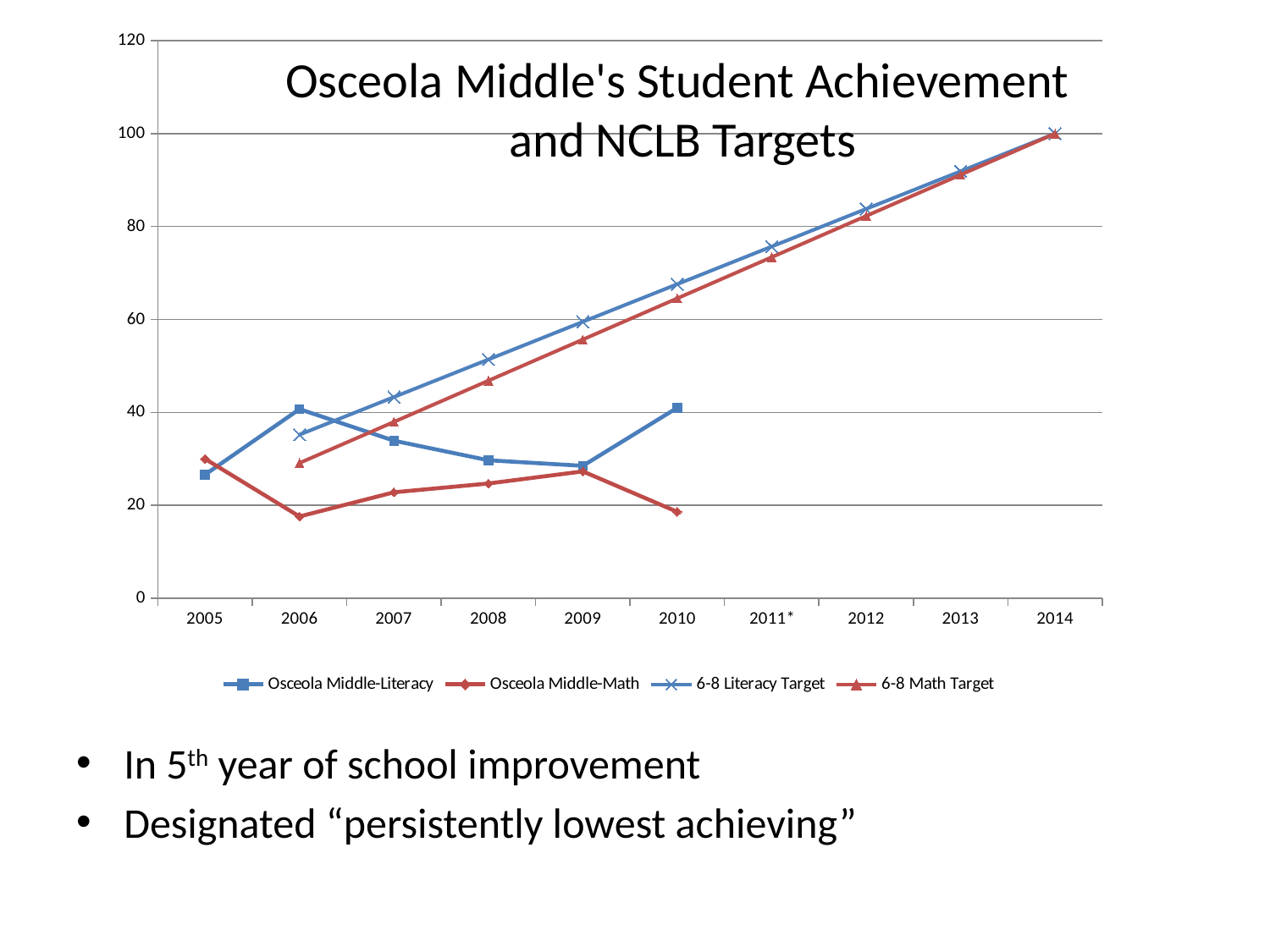
Do the 6-8 Math Target values rise or fall from 2006 to 2014? rise In 2010, which is larger: Osceola Middle-Literacy or Osceola Middle-Math? Osceola Middle-Literacy How many series does the legend list? 4 Is the value for the 6-8 Literacy Target in 2006 greater or less than 40? less In 2008, which is larger: the 6-8 Literacy Target or the 6-8 Math Target? 6-8 Literacy Target Is the value for the 6-8 Math Target in 2012 greater or less than 80? greater What kind of chart is shown on the slide? line chart What is the value of the 6-8 Literacy Target in 2014? 100 How many years are shown along the x axis? 10 What is the title of the chart? Osceola Middle's Student Achievement and NCLB Targets Is the value for Osceola Middle-Math in 2010 greater or less than 20? less